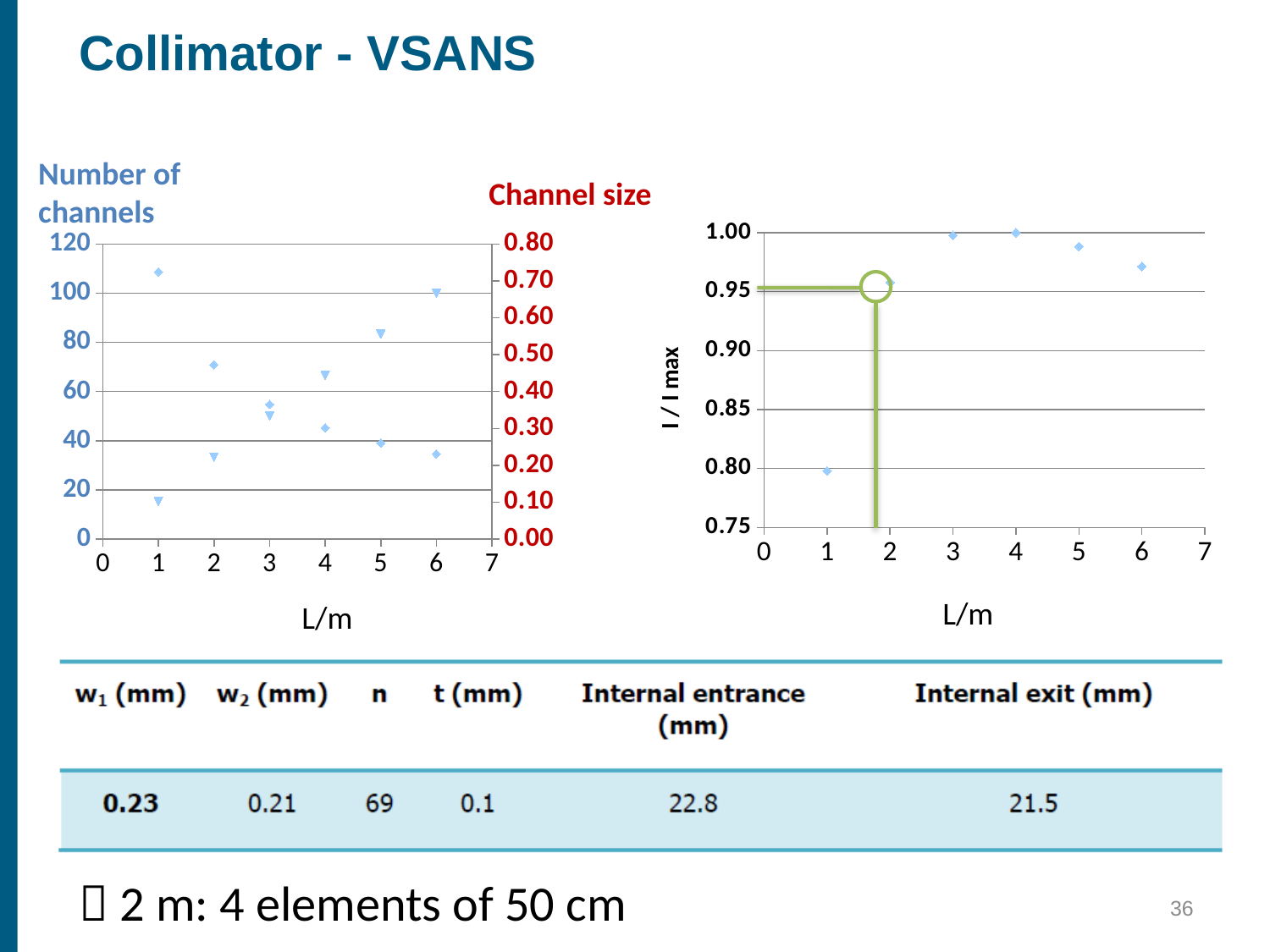
On the left chart, is the number of channels at L/m = 6 greater or less than 40? less On the left chart, is the channel size at L/m = 6 greater or less than 0.60? greater What kind of chart is the left chart (Number of channels / Channel size)? scatter chart On the right chart (I / I max), is the value at L/m = 4 greater or less than 0.95? greater On the left chart, does the channel size rise or fall as L/m increases? rise On the left chart, how many data points does the Number of channels series have? 6 What is the y-axis label of the right chart? I / I max On the left chart, does the number of channels rise or fall as L/m increases? fall On the left chart, at which L/m value is the number of channels highest? 1 On the right chart (I / I max), at which L/m value is I / I max lowest? 1